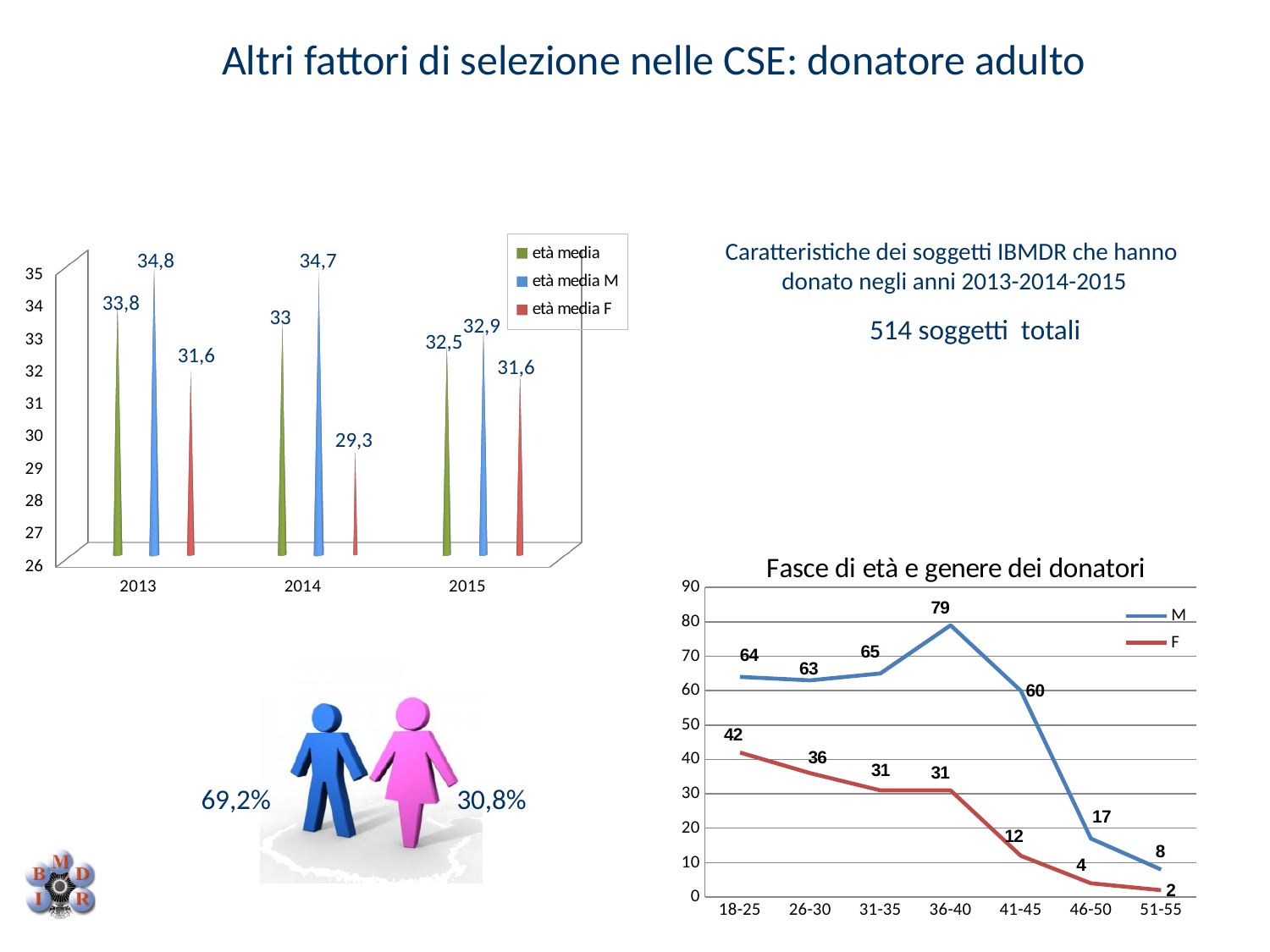
In the chart titled 'Fasce di età e genere dei donatori', what kind of chart is it? line chart In the chart titled 'Fasce di età e genere dei donatori', what is the value for F in the 18-25 age band? 42 In the chart titled 'Fasce di età e genere dei donatori', does the F series rise or fall from 18-25 to 51-55? fall In the chart titled 'Fasce di età e genere dei donatori', what is the difference between M and F in the 41-45 age band? 48 In the chart titled 'Fasce di età e genere dei donatori', which age band has the lowest value for F? 51-55 In the chart titled 'Fasce di età e genere dei donatori', which age band has the highest value for M? 36-40 In the bar chart on the left of the slide, how many series does the legend list? 3 In the chart titled 'Fasce di età e genere dei donatori', how many age bands are shown on the x axis? 7 In the bar chart on the left of the slide, what is the value of 'età media F' for 2014? 29,3 In the chart titled 'Fasce di età e genere dei donatori', what is the value for M in the 36-40 age band? 79 In the bar chart on the left of the slide, what is the value of 'età media M' for 2013? 34,8 In the bar chart on the left of the slide, which is larger for 2015: 'età media M' or 'età media F'? età media M